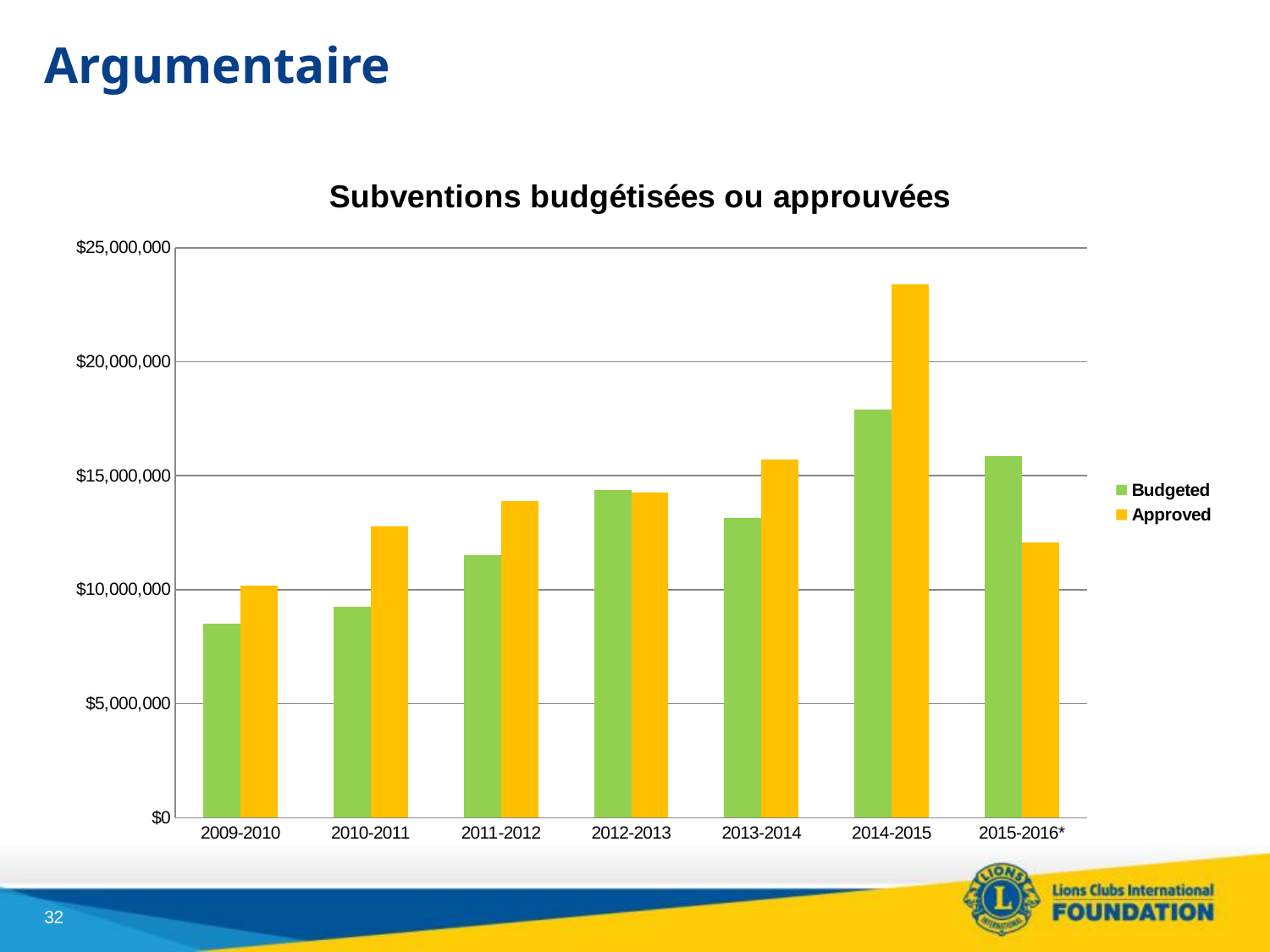
For 2010-2011, which is larger, Budgeted or Approved? Approved What is the title of the chart? Subventions budgétisées ou approuvées Which year has the highest Approved value? 2014-2015 What kind of chart is shown on the slide? Bar chart Is the Budgeted value for 2009-2010 greater or less than $10,000,000? less For 2015-2016*, which is larger, Budgeted or Approved? Budgeted Do the Budgeted values rise or fall from 2009-2010 to 2014-2015? rise How many fiscal-year categories are shown on the x axis? 7 Is the Budgeted value for 2014-2015 greater or less than $15,000,000? greater Which year has the lowest Budgeted value? 2009-2010 How many series does the legend list? 2 Is the Approved value for 2014-2015 greater or less than $20,000,000? greater